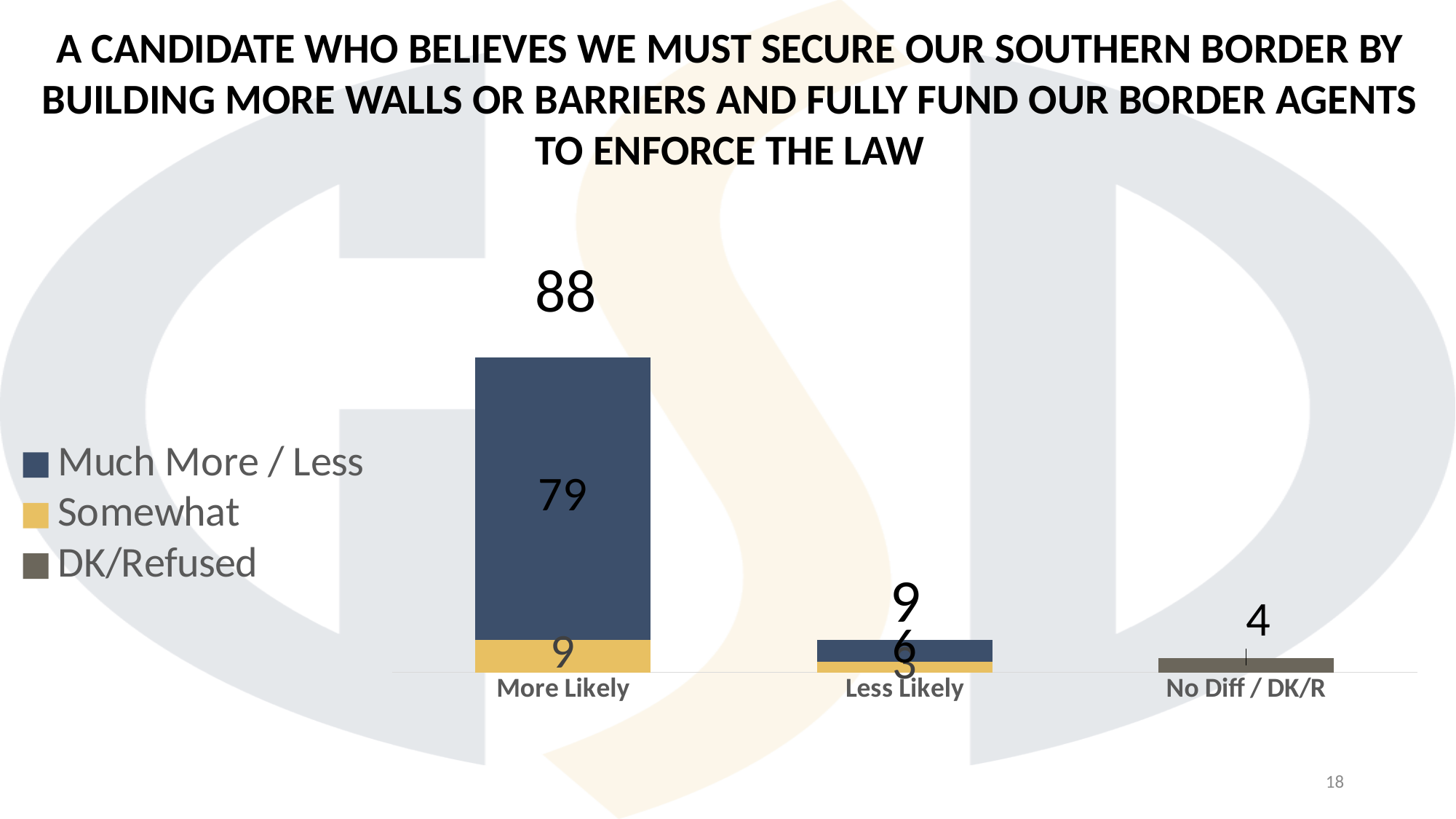
What is the total value shown above the More Likely bar? 88 Which category has the tallest bar? More Likely What kind of chart is shown on the slide? Stacked bar chart What is the total value shown above the Less Likely bar? 9 How many categories are shown on the x axis? 3 Which is larger, the Much More / Less value for More Likely or the Much More / Less value for Less Likely? More Likely What is the difference between the More Likely total (88) and the Less Likely total (9)? 79 What is the value for No Diff / DK/R? 4 What is the Much More / Less value for More Likely? 79 How many series does the legend list? 3 Which category has the shortest bar? No Diff / DK/R What is the Somewhat value for More Likely? 9